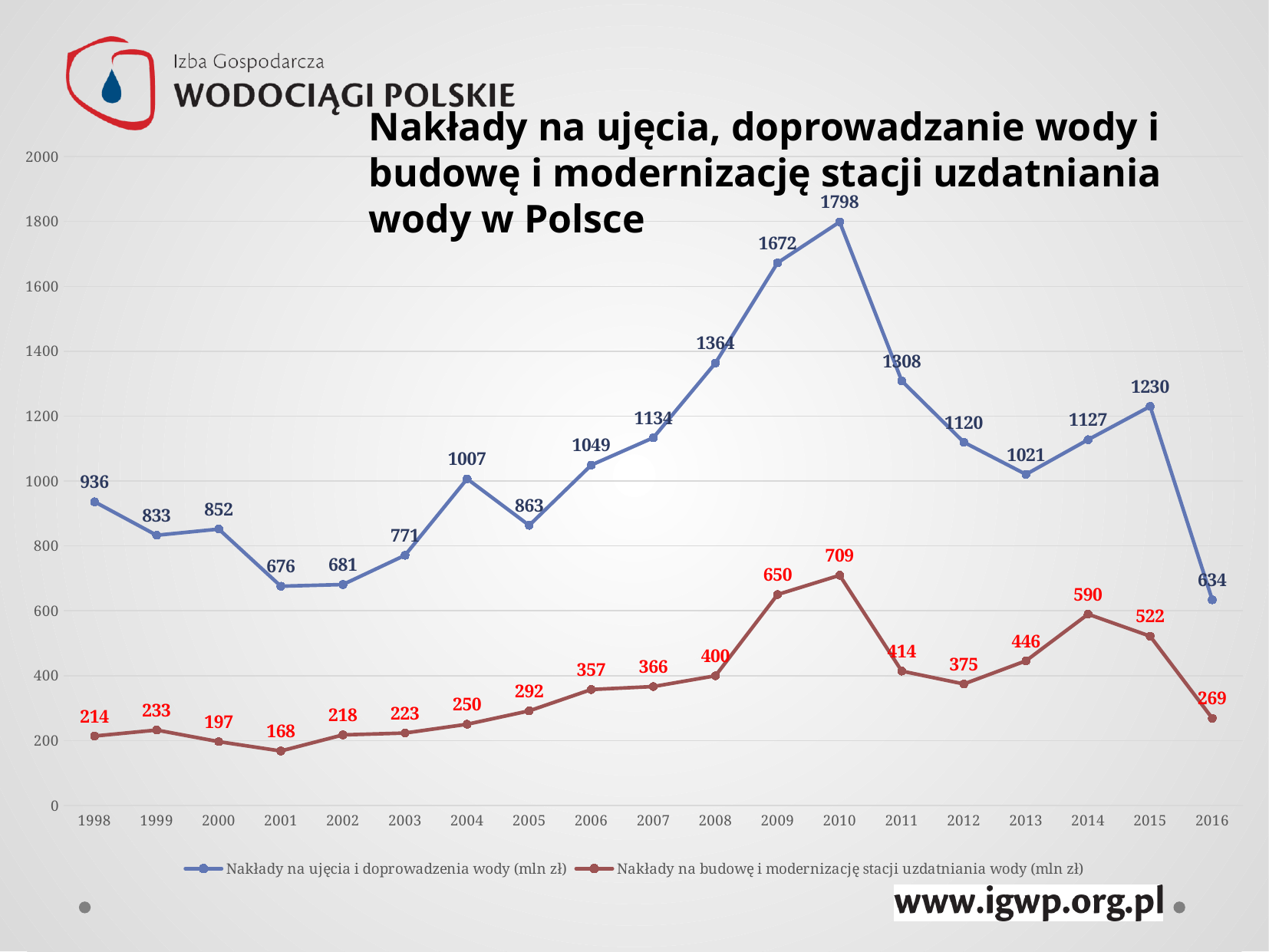
How many series does the legend list? 2 Does 'Nakłady na ujęcia i doprowadzenia wody (mln zł)' rise or fall from 2010 to 2013? fall What is the difference between the two series' values in 2009? 1022 What kind of chart is shown on the slide? line chart Which is larger: 'Nakłady na ujęcia i doprowadzenia wody (mln zł)' in 2004 or in 2005? 2004 In which year is 'Nakłady na ujęcia i doprowadzenia wody (mln zł)' lowest? 2016 In which year is 'Nakłady na budowę i modernizację stacji uzdatniania wody (mln zł)' highest? 2010 Is the value of 'Nakłady na budowę i modernizację stacji uzdatniania wody (mln zł)' in 2014 greater or less than 400? greater What colour is the line for 'Nakłady na budowę i modernizację stacji uzdatniania wody (mln zł)'? red How many years are shown on the x axis? 19 What is the value of 'Nakłady na ujęcia i doprowadzenia wody (mln zł)' in 2010? 1798 What is the value of 'Nakłady na budowę i modernizację stacji uzdatniania wody (mln zł)' in 2016? 269